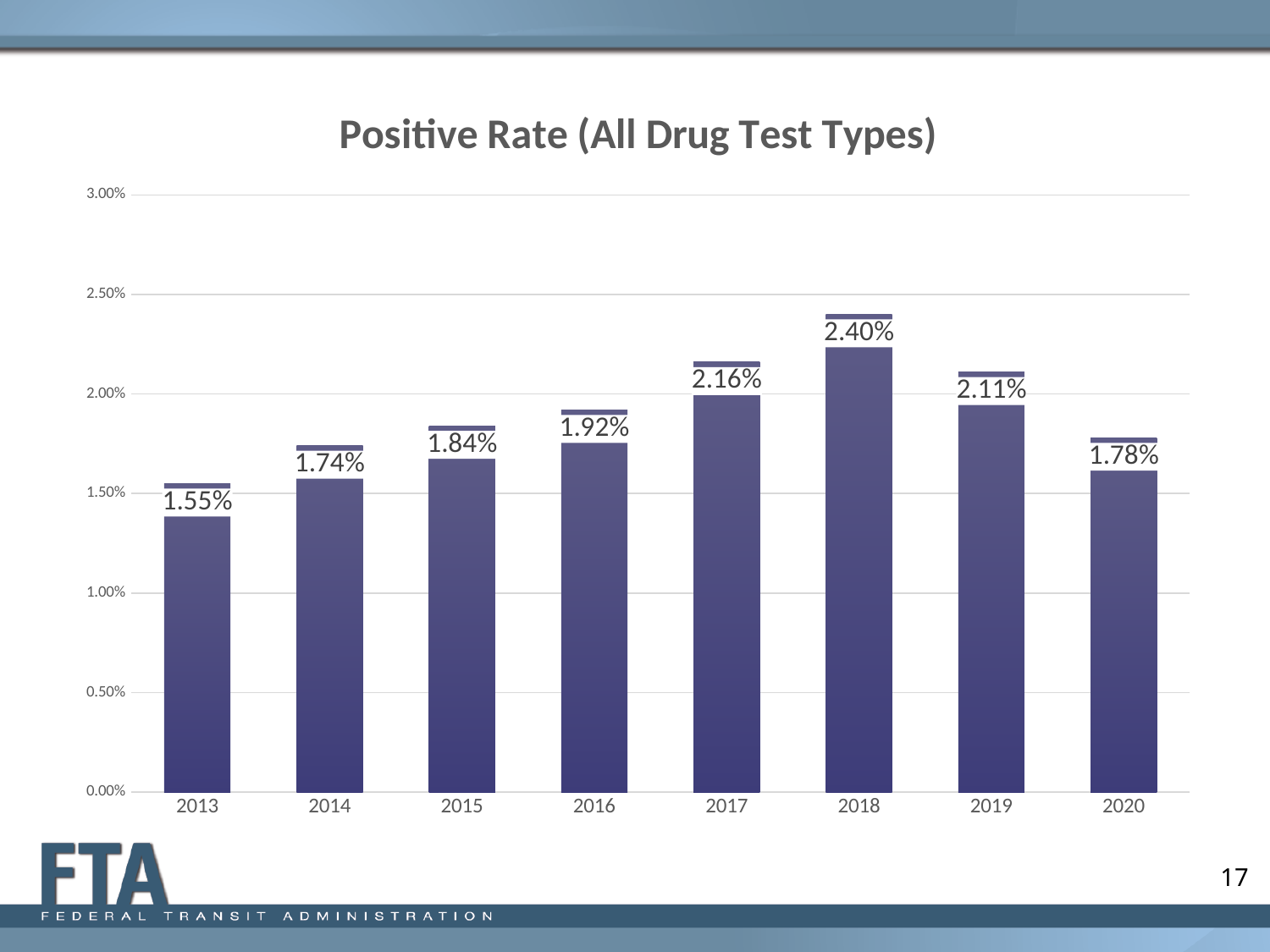
What is the difference between the positive rate in 2018 and in 2013? 0.85% What is the positive rate for 2013? 1.55% Does the positive rate rise or fall from 2013 to 2018? rise Is the positive rate for 2016 greater or less than 2.00%? less What is the positive rate for 2018? 2.40% What kind of chart is shown on the slide? bar chart What is the positive rate for 2020? 1.78% Which year has a higher positive rate, 2017 or 2019? 2017 What is the title of the chart? Positive Rate (All Drug Test Types) Which year has the highest positive rate? 2018 How many years are shown on the chart? 8 Which year has the lowest positive rate? 2013